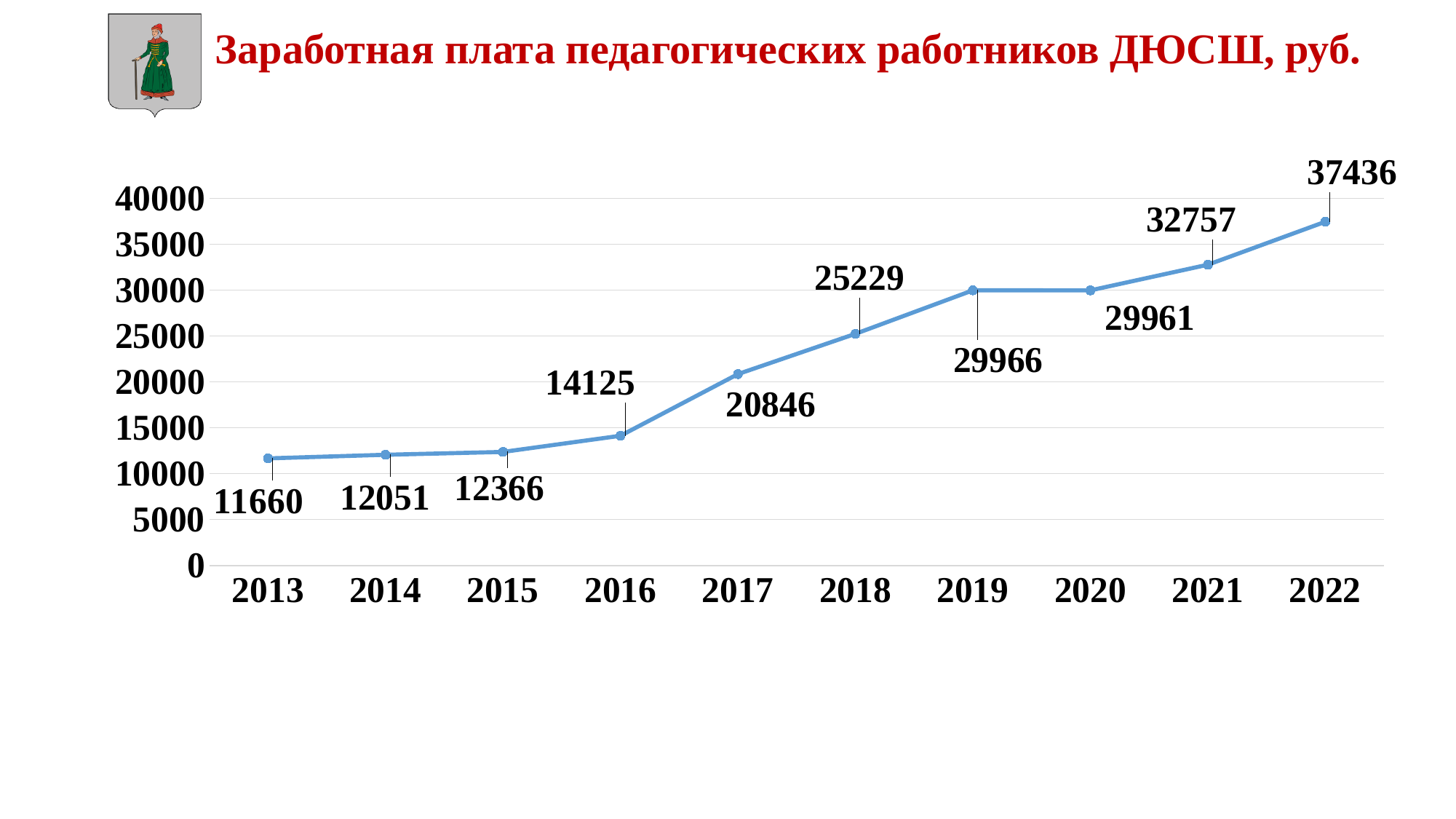
Do the values generally rise or fall from 2013 to 2022? rise What is the difference between the values for 2022 and 2021? 4679 What kind of chart is shown on the slide? line chart What is the value for 2018? 25229 Is the value for 2021 greater or less than 30000? greater Which year has the lowest value? 2013 Which year has the highest value? 2022 What is the value for 2022? 37436 How many years are plotted on the chart? 10 What is the value for 2013? 11660 What is the difference between the values for 2017 and 2016? 6721 Which is larger, the value for 2019 or the value for 2020? 2019